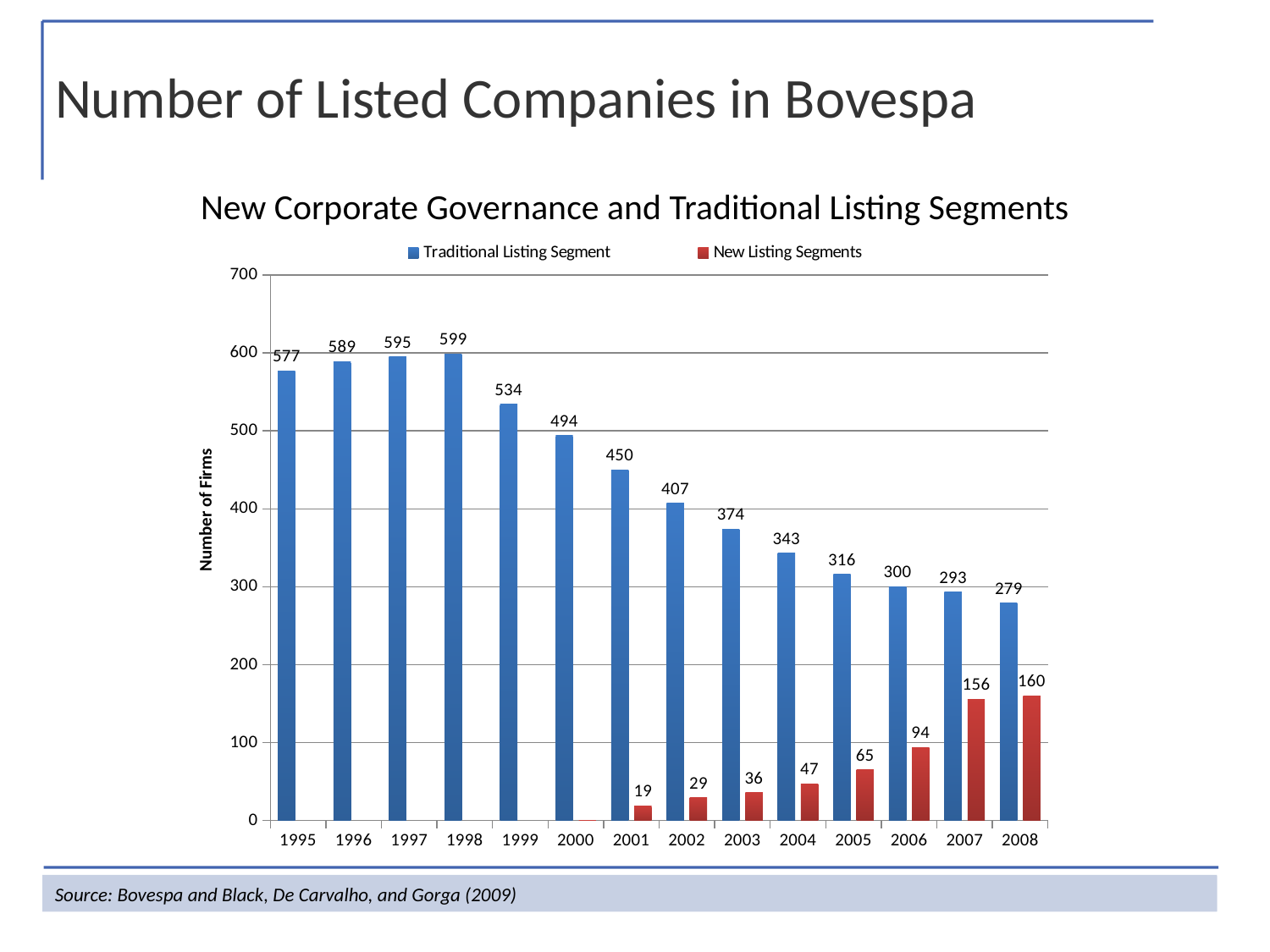
Does the Traditional Listing Segment rise or fall from 1998 to 2008? Fall What is the label of the y axis? Number of Firms In which year is the Traditional Listing Segment value highest? 1998 What is the value for the Traditional Listing Segment in 1998? 599 What is the difference between the Traditional Listing Segment values in 1995 and 2008? 298 What kind of chart is shown on the slide? Bar chart How many years are shown on the x axis? 14 How many series does the legend list? 2 What is the value for New Listing Segments in 2006? 94 Is the value for the Traditional Listing Segment in 2000 greater or less than 500? less Which is larger in 2007: the Traditional Listing Segment or New Listing Segments? Traditional Listing Segment